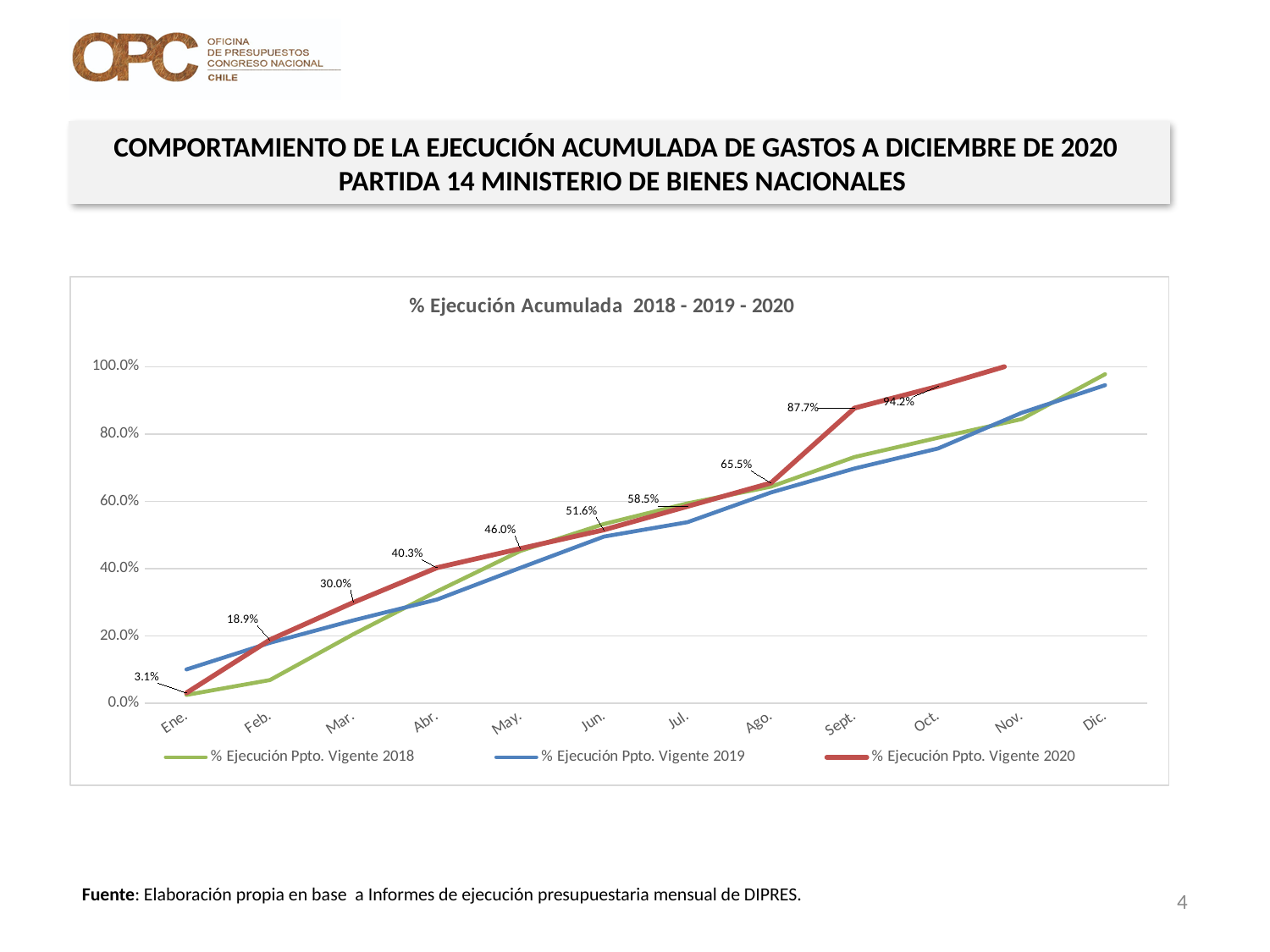
What is the value for % Ejecución Ppto. Vigente 2020 in Feb.? 18.9% What kind of chart is shown on the slide? line chart How many series does the legend list? 3 What is the value for % Ejecución Ppto. Vigente 2020 in Ago.? 65.5% In Mar., which series has the higher value, % Ejecución Ppto. Vigente 2020 or % Ejecución Ppto. Vigente 2018? % Ejecución Ppto. Vigente 2020 How many months are shown on the x axis? 12 What is the value for % Ejecución Ppto. Vigente 2020 in Abr.? 40.3% What is the difference between the 2020 values for Oct. and Sept.? 6.5% What is the value for % Ejecución Ppto. Vigente 2020 in Sept.? 87.7% By how much did % Ejecución Ppto. Vigente 2020 increase from Ago. to Sept.? 22.2% Is the value for % Ejecución Ppto. Vigente 2019 in Ene. greater or less than 20.0%? less Do the values for % Ejecución Ppto. Vigente 2020 rise or fall from Ene. to Oct.? rise